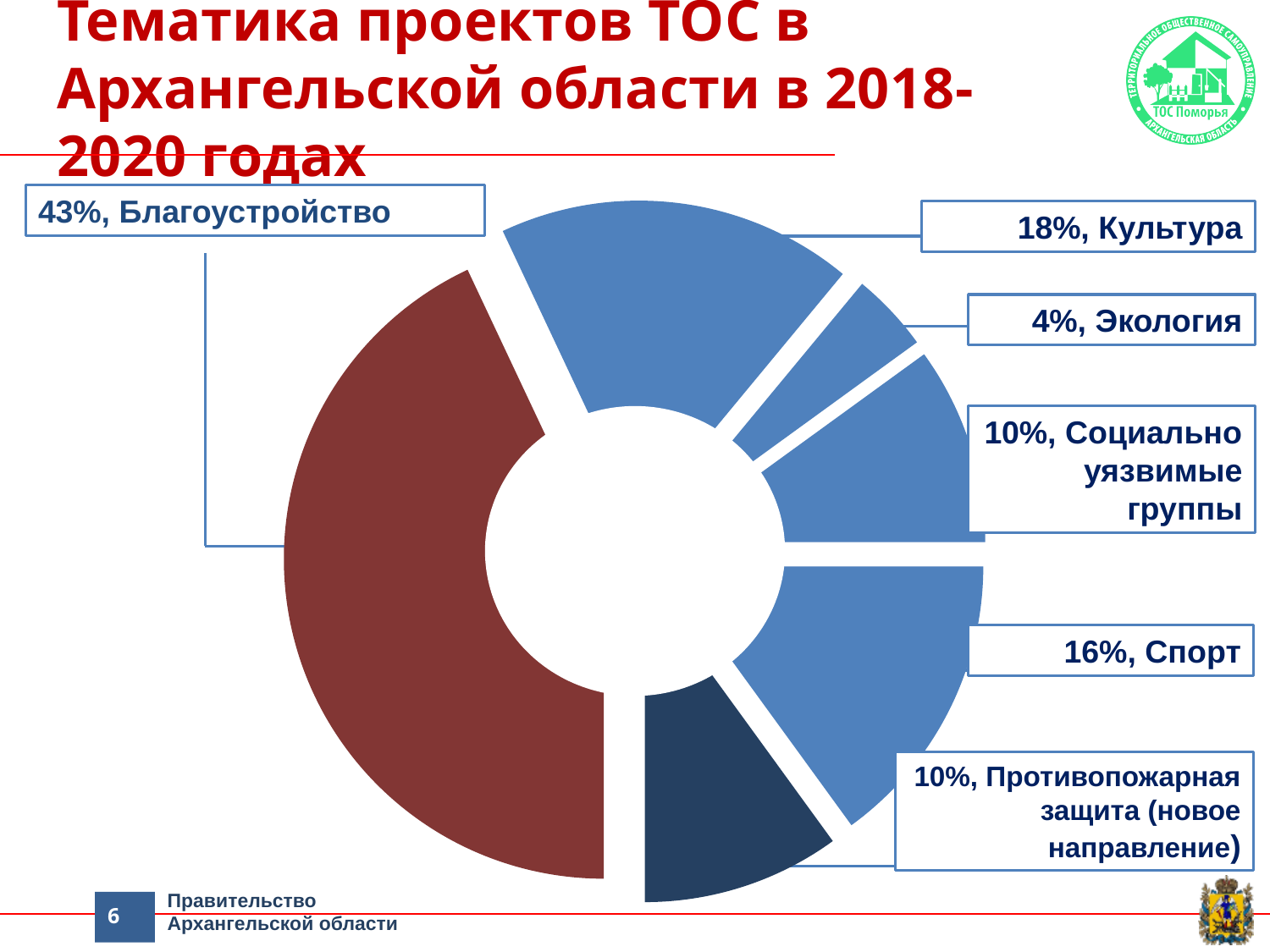
Which has a larger share, Культура or Спорт? Культура How many project themes are shown in the chart? 6 What kind of chart is shown on the slide? doughnut chart What share of TOS projects is for Благоустройство? 43% What is the difference in percentage points between Благоустройство and Культура? 25 What colour is the Благоустройство segment? dark red What is the difference in percentage points between Спорт and Экология? 12 What share is shown for Противопожарная защита (новое направление)? 10% Which project theme has the smallest share? Экология Which project theme has the largest share? Благоустройство What percentage is shown for Спорт? 16% What percentage is shown for Культура? 18%